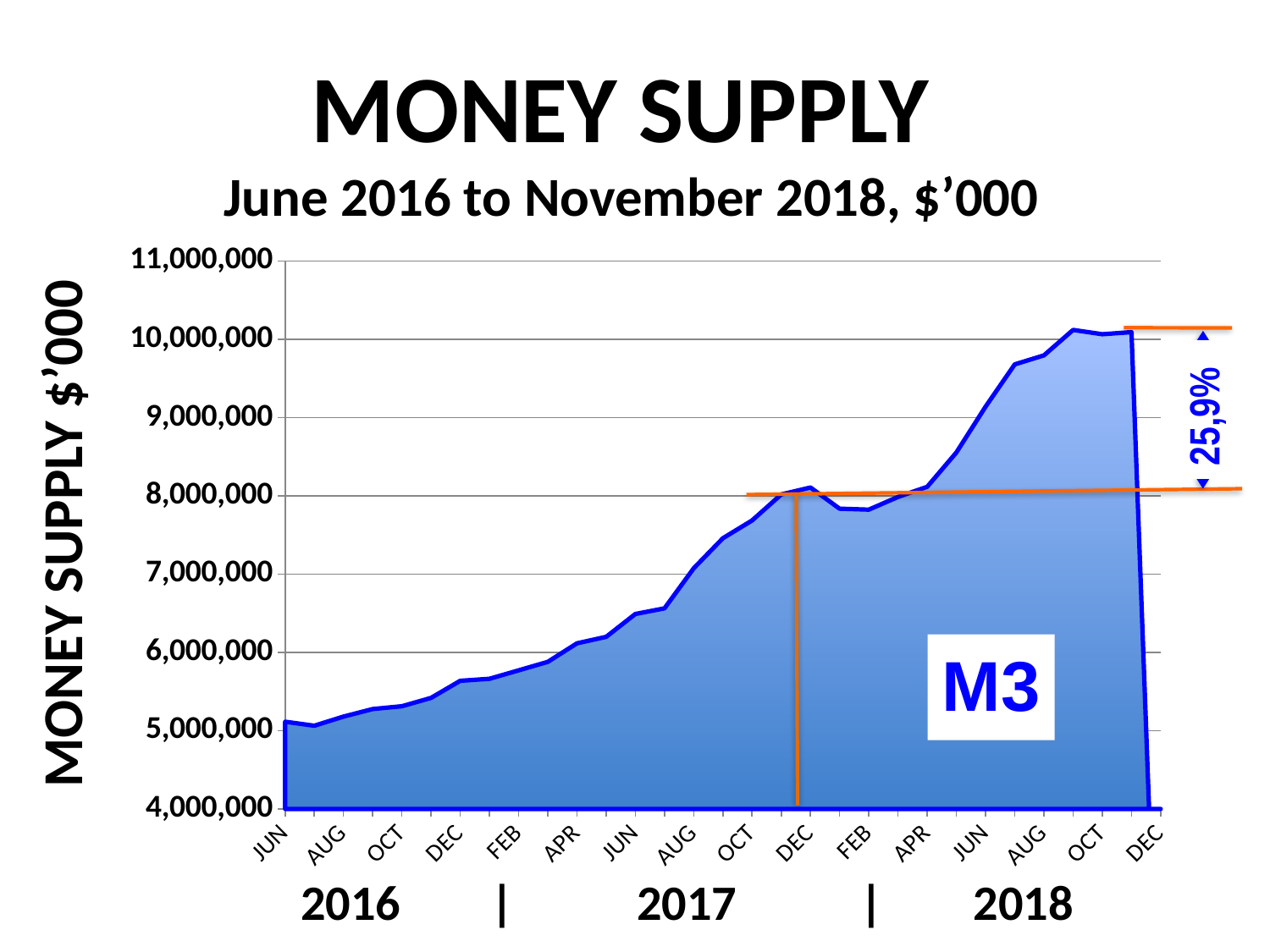
Is the value for DEC 2017 greater or less than 7,000,000? greater In which year does the series reach its highest value? 2018 Is the value for FEB 2018 greater or less than 9,000,000? less Is the value for AUG 2018 greater or less than 9,000,000? greater What percentage change is annotated on the chart between the two orange horizontal lines? 25,9% What kind of chart is shown on the slide? area chart Does the money supply generally rise or fall from June 2016 to November 2018? rise What is the title of the chart? MONEY SUPPLY What label is shown on the vertical axis? MONEY SUPPLY $'000 Which is larger, the value for DEC 2016 or the value for DEC 2017? DEC 2017